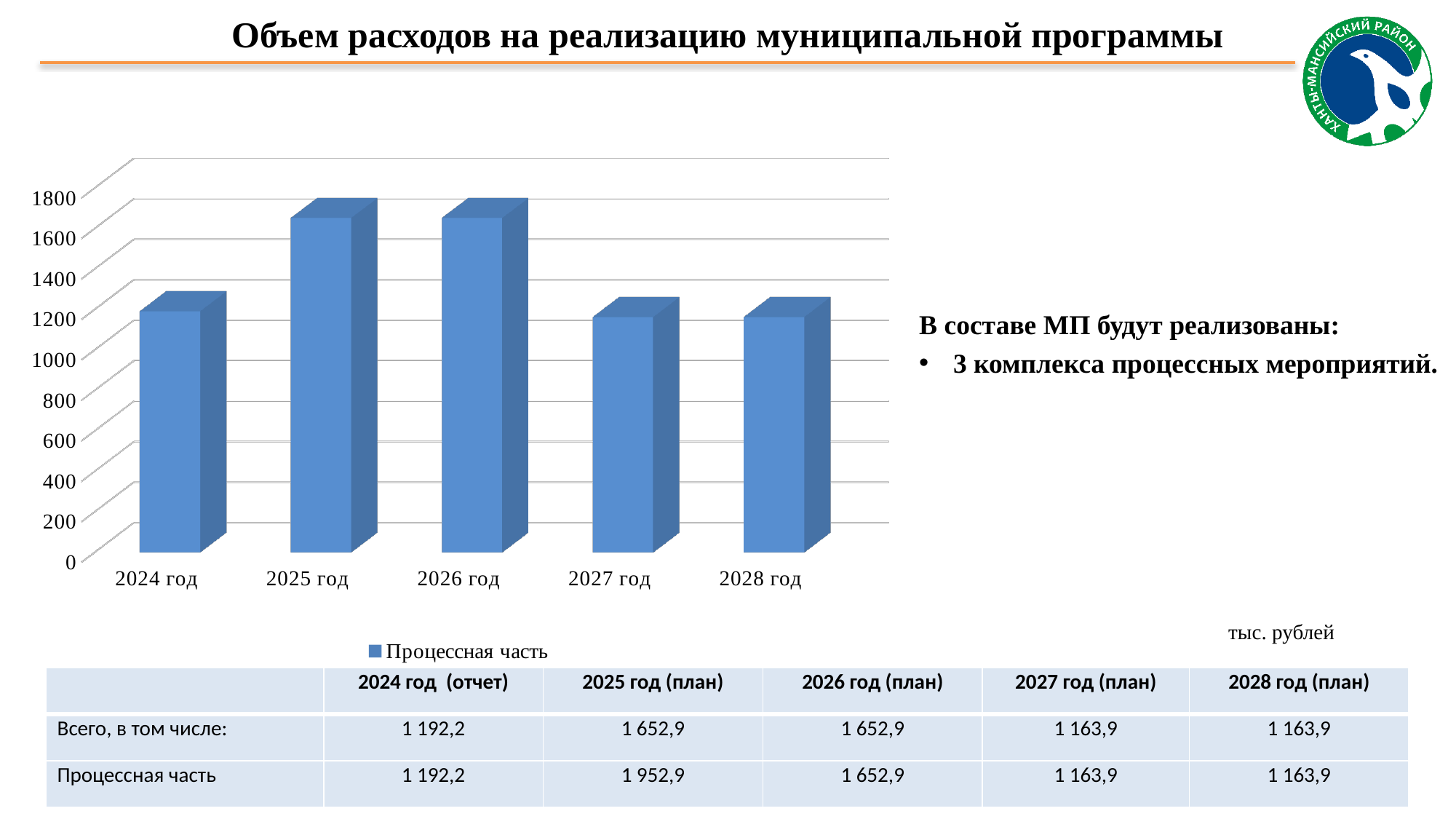
How many series does the chart legend list? 1 Is the value for 2026 год greater or less than 1800? less What kind of chart is shown on the slide? bar chart How many categories (years) are shown on the x axis of the chart? 5 What is the title of the slide containing the chart? Объем расходов на реализацию муниципальной программы Is the value for 2025 год greater or less than 1400? greater Is the value for 2027 год greater or less than 1400? less Does the value rise or fall from 2024 год to 2025 год? rise What is the name of the series shown in the chart legend? Процессная часть Which is larger, the value for 2025 год or the value for 2027 год? 2025 год